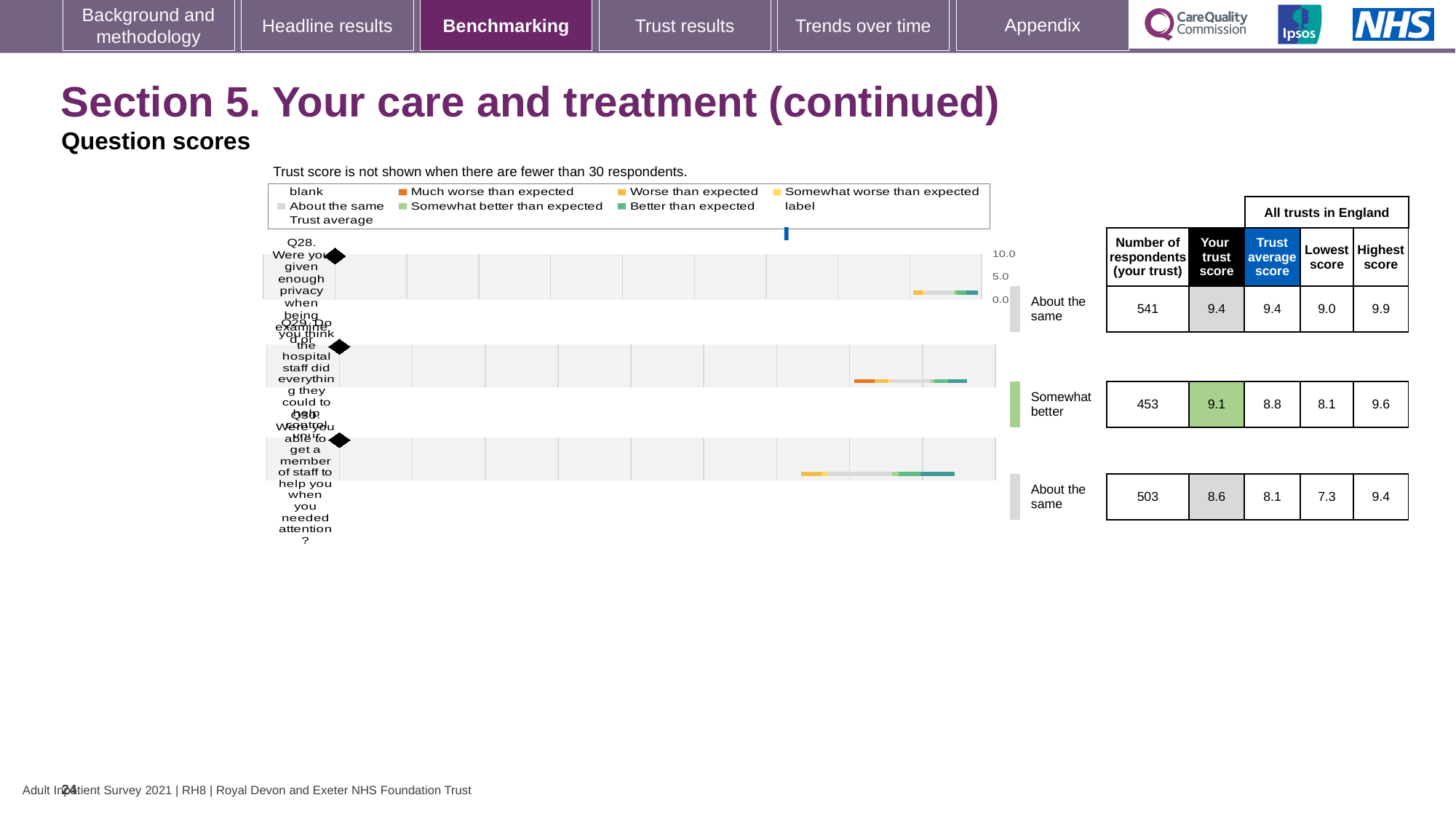
Which question has the highest 'Your trust score'? Q28 What is the 'Your trust score' for Q28? 9.4 What benchmark category is shown next to Q29? Somewhat better What is the lowest score across all trusts in England for Q29? 8.1 What is the difference between 'Your trust score' and the trust average score for Q30? 0.5 How many respondents (your trust) are shown for Q29? 453 What is the trust average score for Q29? 8.8 What kind of chart is used to show the question scores? Bar chart What is the highest score across all trusts in England for Q30? 9.4 How many questions are plotted on the chart? 3 Which question has the lowest number of respondents? Q29 Which is larger, the 'Your trust score' for Q28 or for Q30? Q28